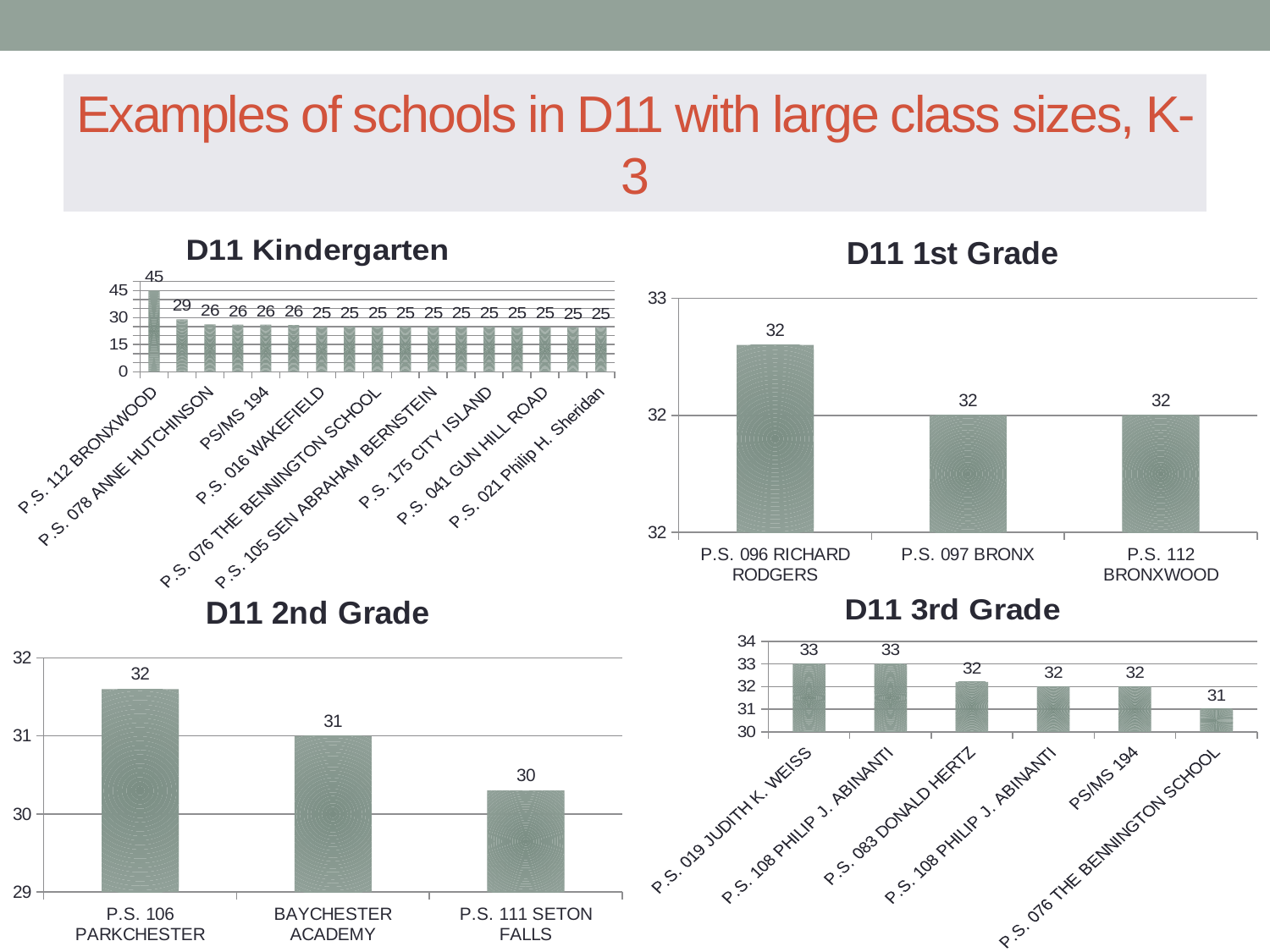
In the D11 2nd Grade chart, what is the value for P.S. 106 PARKCHESTER? 32 In the D11 Kindergarten chart, which school has the highest value, and what is it? P.S. 112 BRONXWOOD, 45 In the D11 2nd Grade chart, which school has the lowest value? P.S. 111 SETON FALLS What type of chart is the D11 Kindergarten chart? bar chart In the D11 3rd Grade chart, what is the value for P.S. 083 DONALD HERTZ? 32 In the D11 3rd Grade chart, is the value for P.S. 019 JUDITH K. WEISS larger or smaller than the value for P.S. 076 THE BENNINGTON SCHOOL? larger In the D11 2nd Grade chart, do the values rise or fall from left to right? fall In the D11 2nd Grade chart, what is the difference between P.S. 106 PARKCHESTER and P.S. 111 SETON FALLS? 2 In the D11 1st Grade chart, what is the value for P.S. 097 BRONX? 32 How many bars are in the D11 3rd Grade chart? 6 In the D11 3rd Grade chart, which school has the lowest value? P.S. 076 THE BENNINGTON SCHOOL How many schools are shown in the D11 1st Grade chart? 3